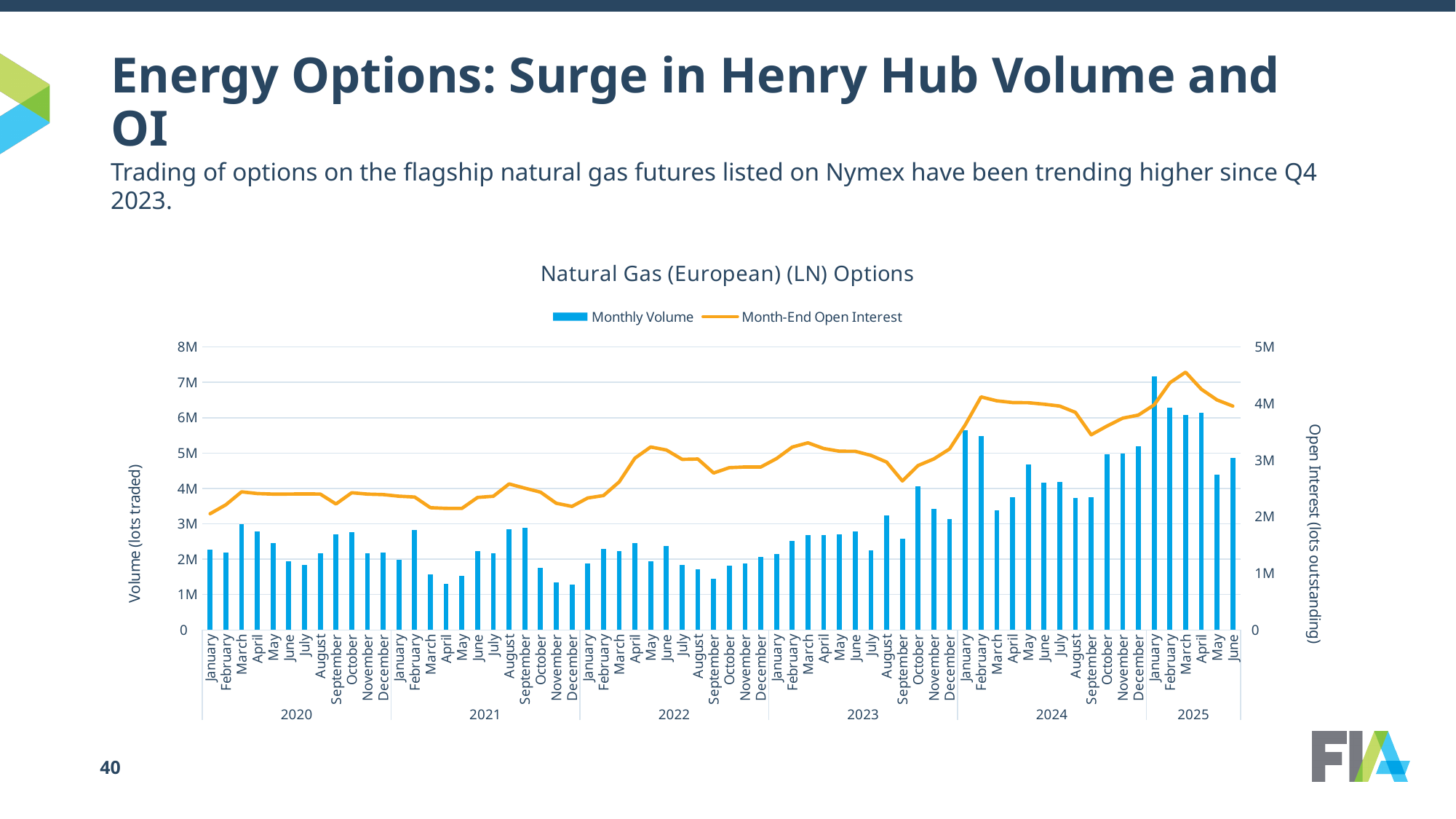
Overall, does Monthly Volume rise or fall from 2020 to 2025? Rise What is the title of the chart? Natural Gas (European) (LN) Options Is the Monthly Volume for January 2025 greater or less than 6M? greater Is the Monthly Volume for April 2021 greater or less than 2M? less What is the label of the right-hand vertical axis? Open Interest (lots outstanding) Which has the larger Monthly Volume, February 2025 or June 2025? February 2025 Is the Month-End Open Interest for March 2025 greater or less than 4M? greater Which has the larger Monthly Volume, January 2020 or January 2025? January 2025 What kind of chart is used to show Monthly Volume? Bar chart How many series does the chart legend list? 2 Which month has the highest Monthly Volume bar? January 2025